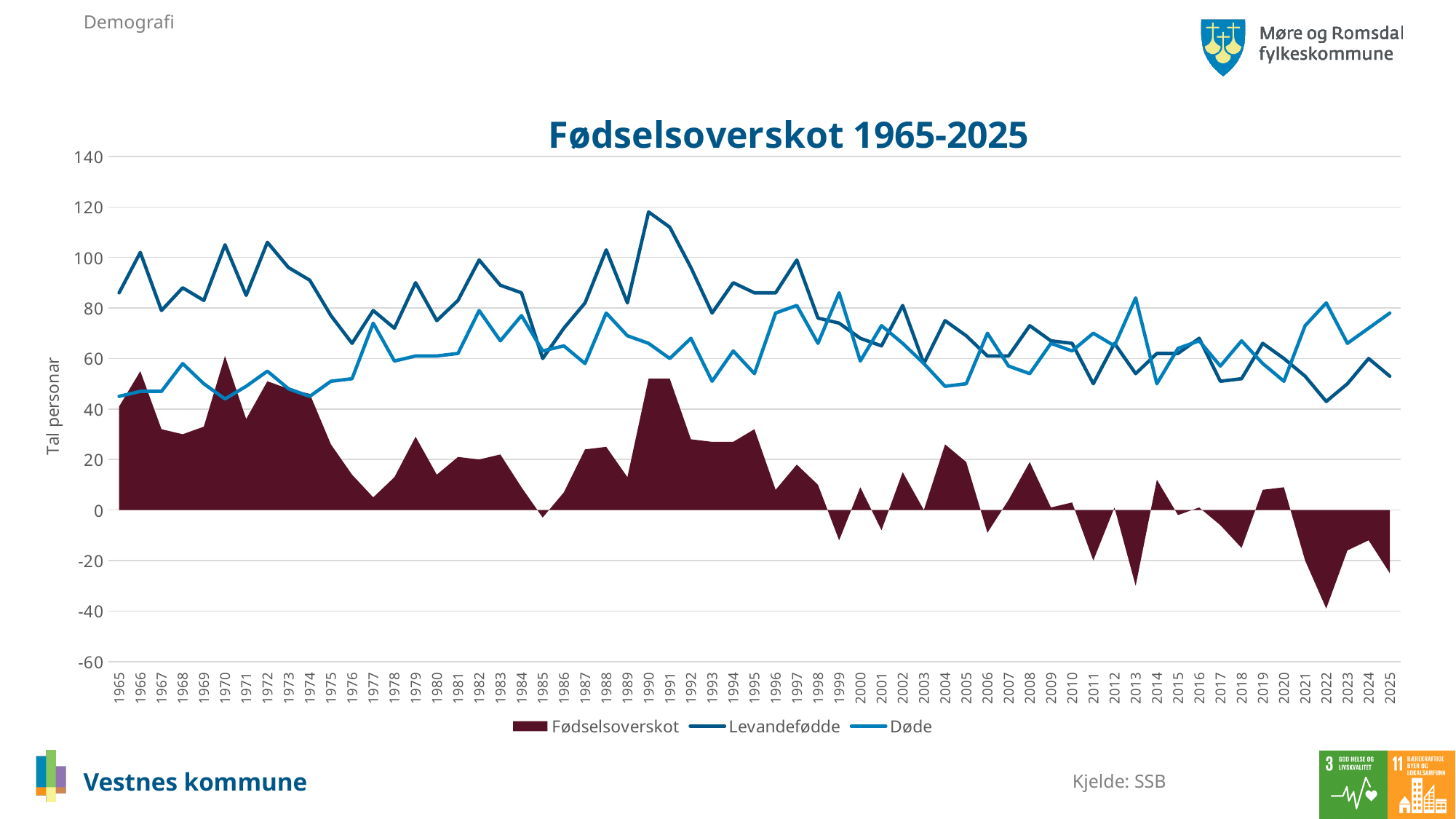
In which year is Fødselsoverskot at its lowest? 2022 In which year is Levandefødde at its highest? 1990 Is the value for Fødselsoverskot in 1970 greater or less than 40? greater How many series does the legend list? 3 Is the value for Levandefødde in 2022 greater or less than 60? less Is the value for Levandefødde in 1990 greater or less than 100? greater Does Levandefødde rise or fall overall from 1965 to 2025? fall What is the title of the chart? Fødselsoverskot 1965-2025 In 2025, which is larger: Levandefødde or Døde? Døde What is the label on the vertical axis? Tal personar What kind of chart is this? line chart with a filled area series